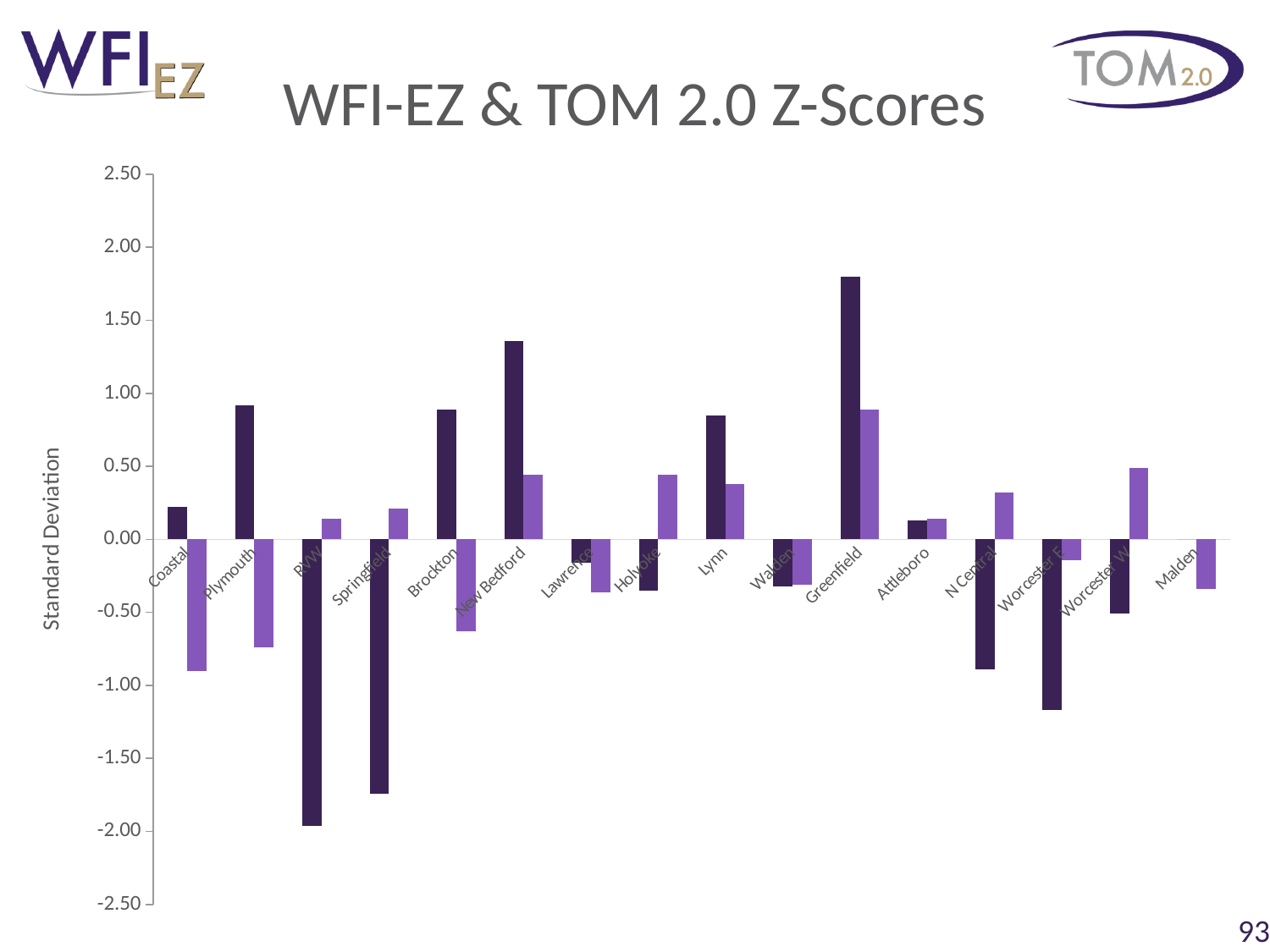
Which is larger, the dark purple bar for Plymouth or the dark purple bar for Coastal? Plymouth What is the title of the chart? WFI-EZ & TOM 2.0 Z-Scores Is the light purple bar for Coastal greater or less than -0.50? less How many categories are shown along the x axis of the chart? 16 What is the label on the vertical axis of the chart? Standard Deviation What kind of chart is shown on the slide? bar chart Which category has the highest dark purple bar? Greenfield Is the dark purple bar for Greenfield greater or less than 1.50? greater Is the dark purple bar for Springfield greater or less than -1.50? less Which category has the highest light purple bar? Greenfield Which category has the lowest light purple bar? Coastal